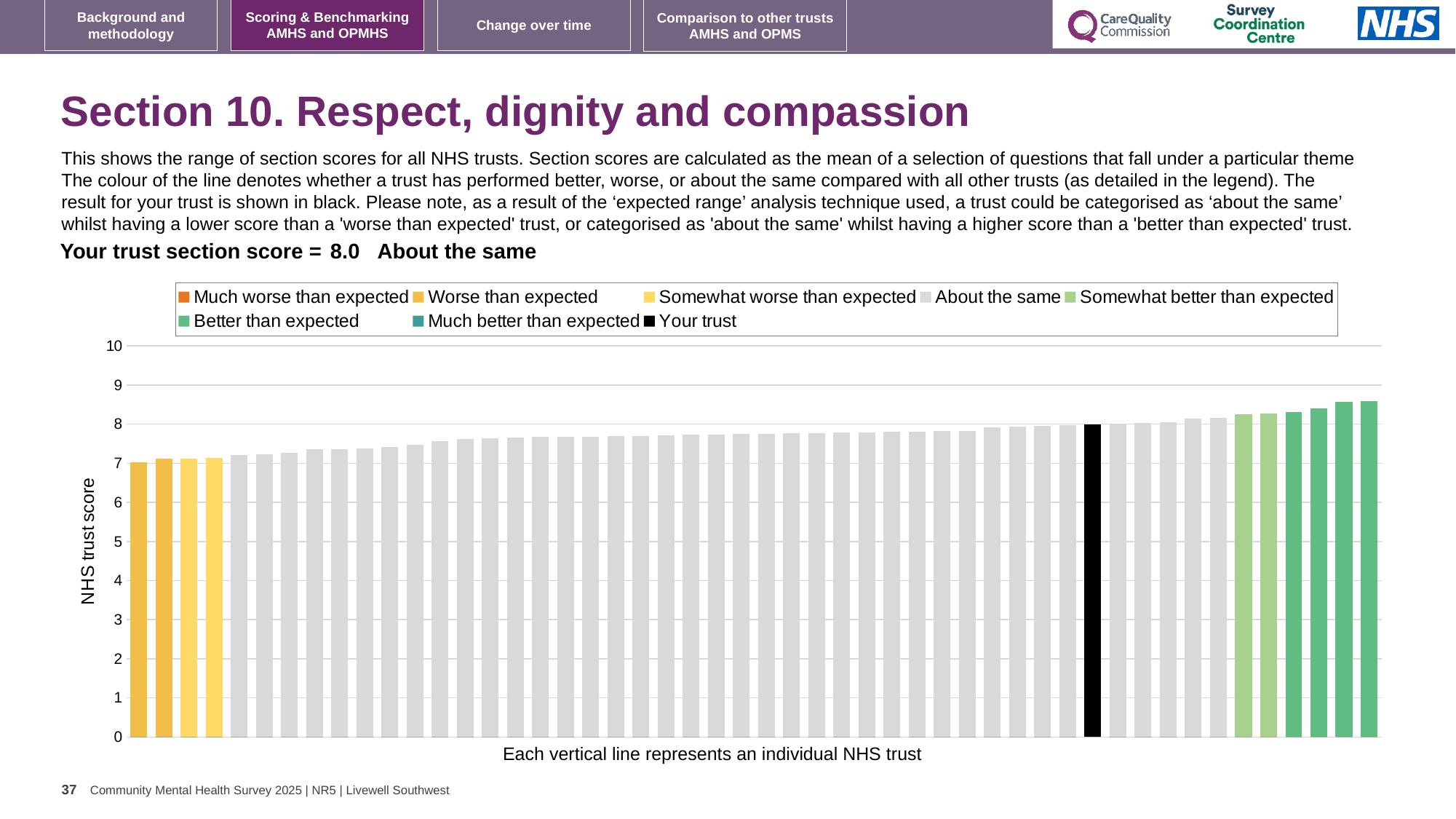
How many entries does the chart legend list? 8 Is the value of the black 'Your trust' bar greater or less than 9? less Is the value of the rightmost bar greater or less than 8? greater What is the section score for your trust shown on the slide? 8.0 What colour is used for the 'Your trust' bar in the chart? black What kind of chart is shown on the slide? bar chart Which benchmark category is your trust placed in for this section? About the same How many bars are coloured as 'Better than expected' (dark green)? 4 Is the value of the tallest bar greater or less than 9? less What is the label on the vertical axis of the chart? NHS trust score Do the bar values rise or fall from left to right across the chart? rise